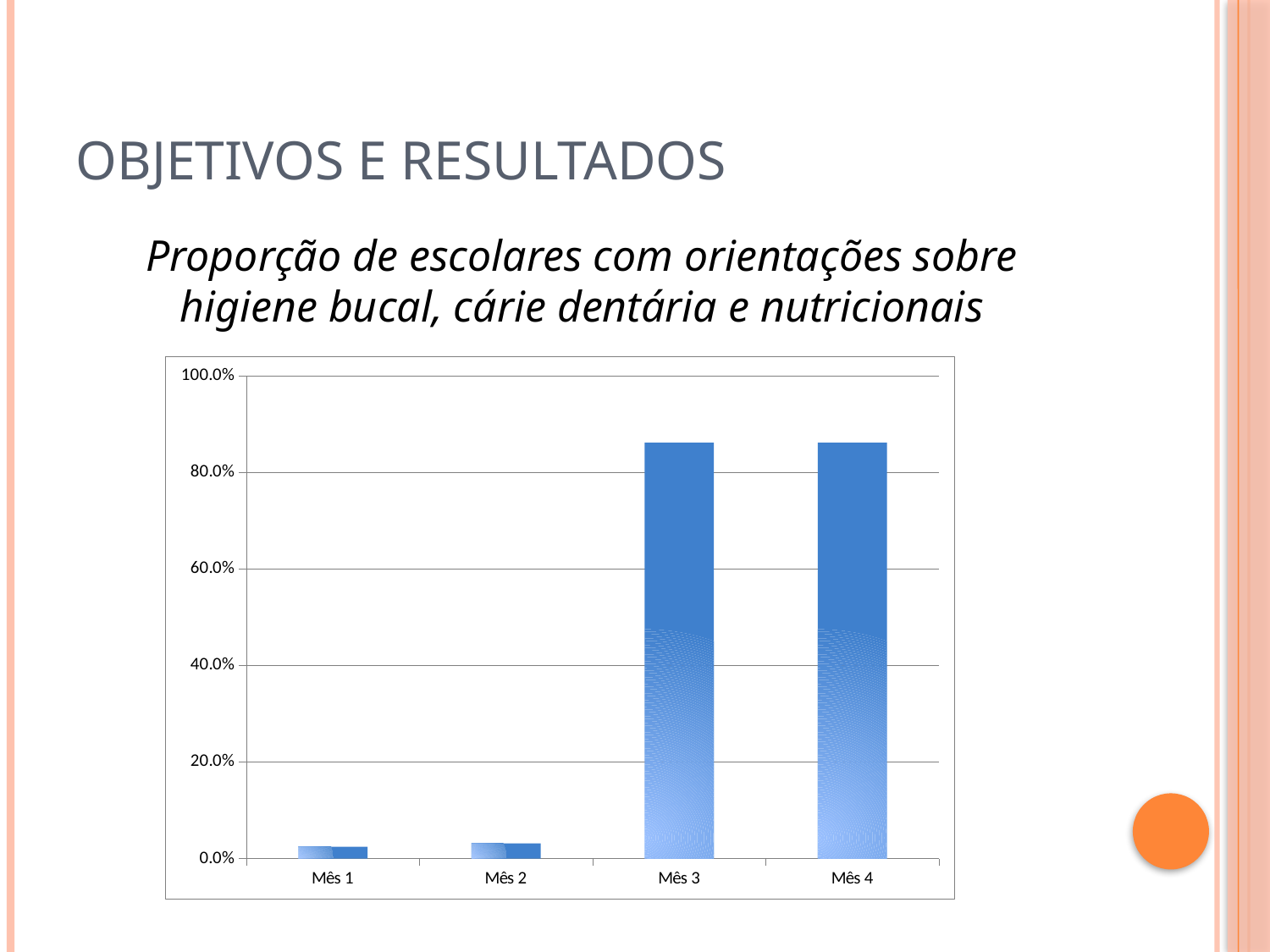
What kind of chart is shown on the slide? bar chart Which is larger, the value for Mês 1 or the value for Mês 3? Mês 3 How many categories are shown on the x axis of the chart? 4 What is the highest value shown on the y axis of the chart? 100.0% Is the value for Mês 3 greater or less than 60.0%? greater Is the value for Mês 1 greater or less than 20.0%? less Is the value for Mês 3 greater or less than 80.0%? greater What is the label of the first category on the x axis? Mês 1 Which is larger, the value for Mês 2 or the value for Mês 4? Mês 4 Do the values generally rise or fall from Mês 1 to Mês 4? rise